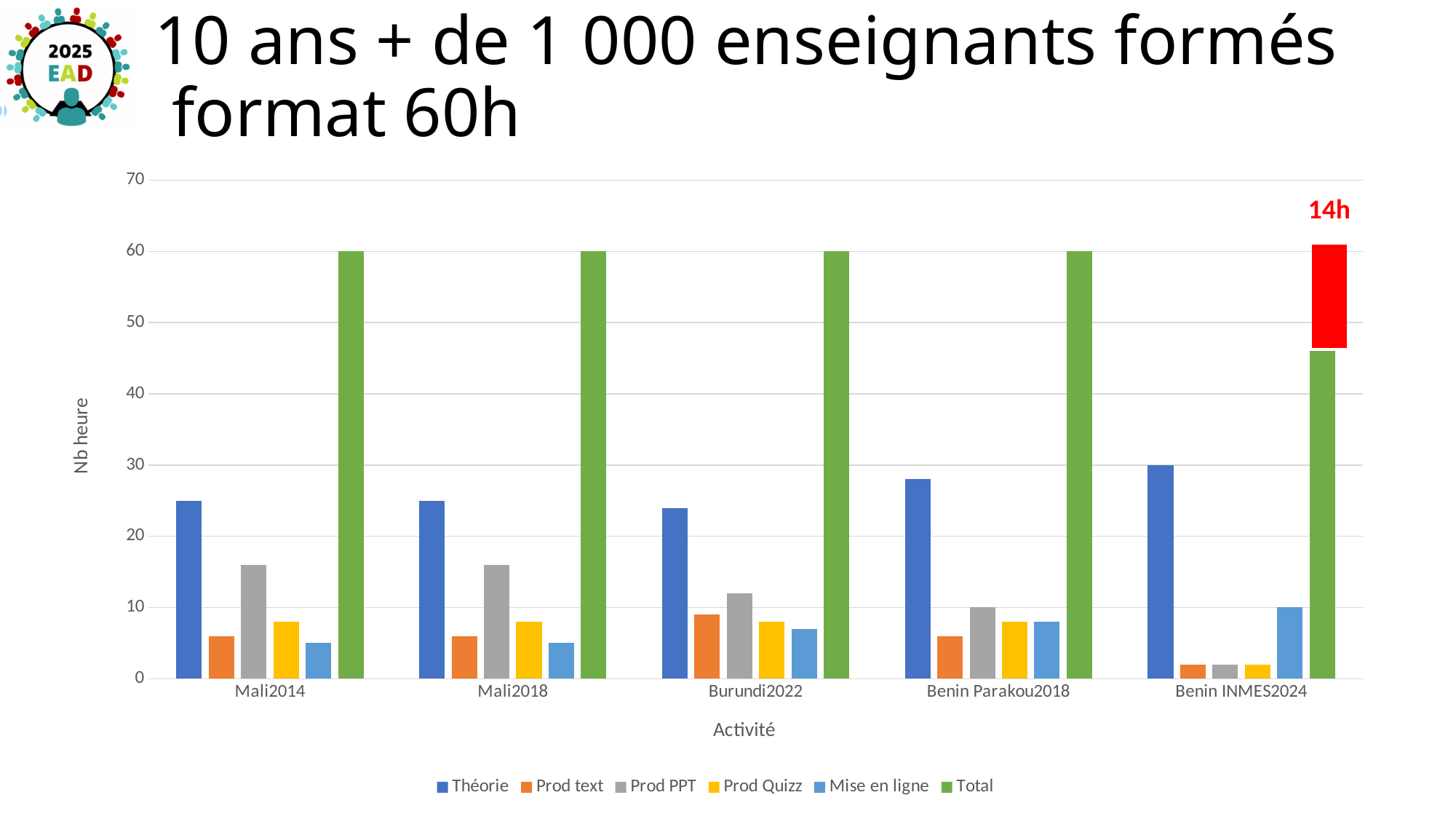
Is the Théorie value for Mali2014 greater or less than 20? greater For Burundi2022, which is larger: Théorie or Prod PPT? Théorie How many categories are shown on the x axis? 5 Is the Prod text value for Benin INMES2024 greater or less than 10? less What kind of chart is shown on the slide? bar chart Which category has the lowest Total value? Benin INMES2024 How many series does the legend list? 6 Is the Mise en ligne value for Mali2018 greater or less than 10? less What is the Théorie value for Benin INMES2024? 30 What is the title of the x axis? Activité What is the Total value for Mali2014? 60 What red annotation is shown above the Benin INMES2024 bars? 14h